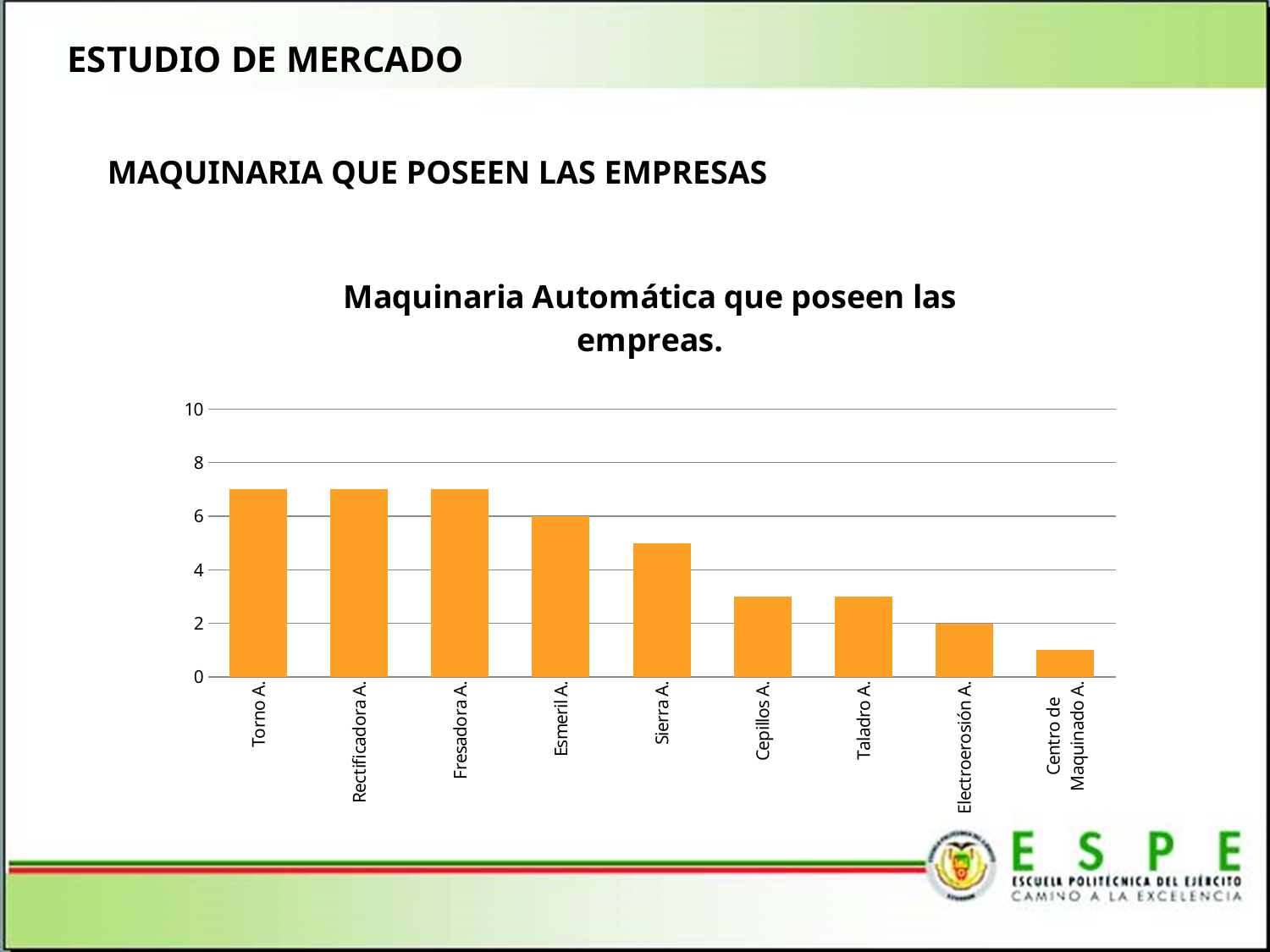
What is the value for Esmeril A.? 6 What is the title of the chart? Maquinaria Automática que poseen las empreas. Is the value for Cepillos A. greater or less than 4? less Is the value for Torno A. greater or less than 6? greater How many categories are shown on the x axis of the chart? 9 What type of chart is shown on the slide? bar chart Is the value for Sierra A. greater or less than 4? greater Which has a larger value, Sierra A. or Taladro A.? Sierra A. What is the value for Electroerosión A.? 2 Do the values rise or fall from left to right along the x axis? fall Which category has the lowest value in the chart? Centro de Maquinado A.